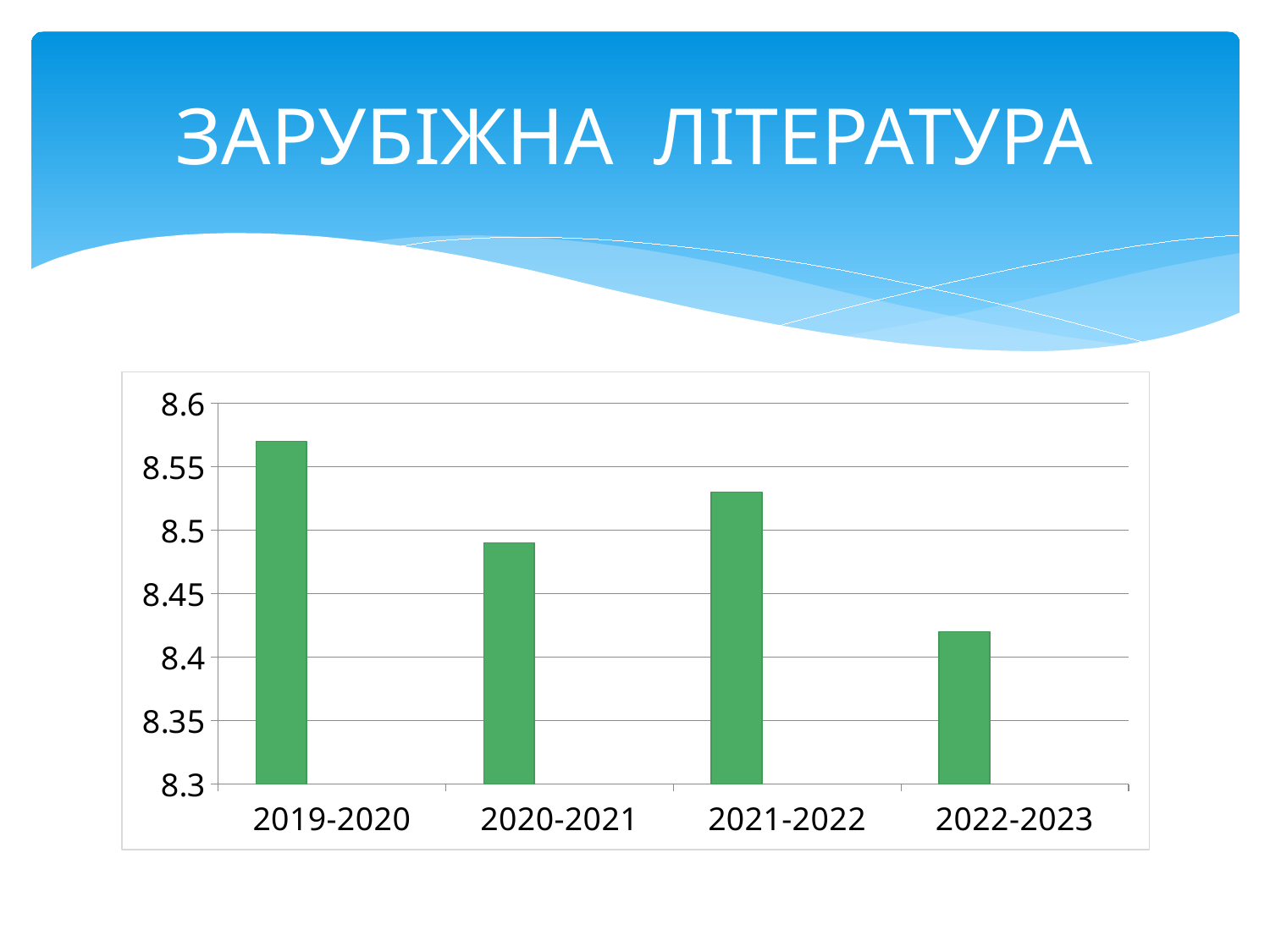
Which school year has the lowest value? 2022-2023 Overall, do the values rise or fall from 2019-2020 to 2022-2023? fall Is the value for 2021-2022 greater or less than 8.5? greater Is the value for 2019-2020 greater or less than 8.55? greater What is the title shown at the top of the slide? ЗАРУБІЖНА ЛІТЕРАТУРА Which is larger, the value for 2019-2020 or the value for 2020-2021? 2019-2020 How many categories (school years) are shown on the x axis? 4 What kind of chart is shown on the slide? bar chart Is the value for 2020-2021 greater or less than 8.5? less Which school year has the highest value? 2019-2020 Which is larger, the value for 2021-2022 or the value for 2022-2023? 2021-2022